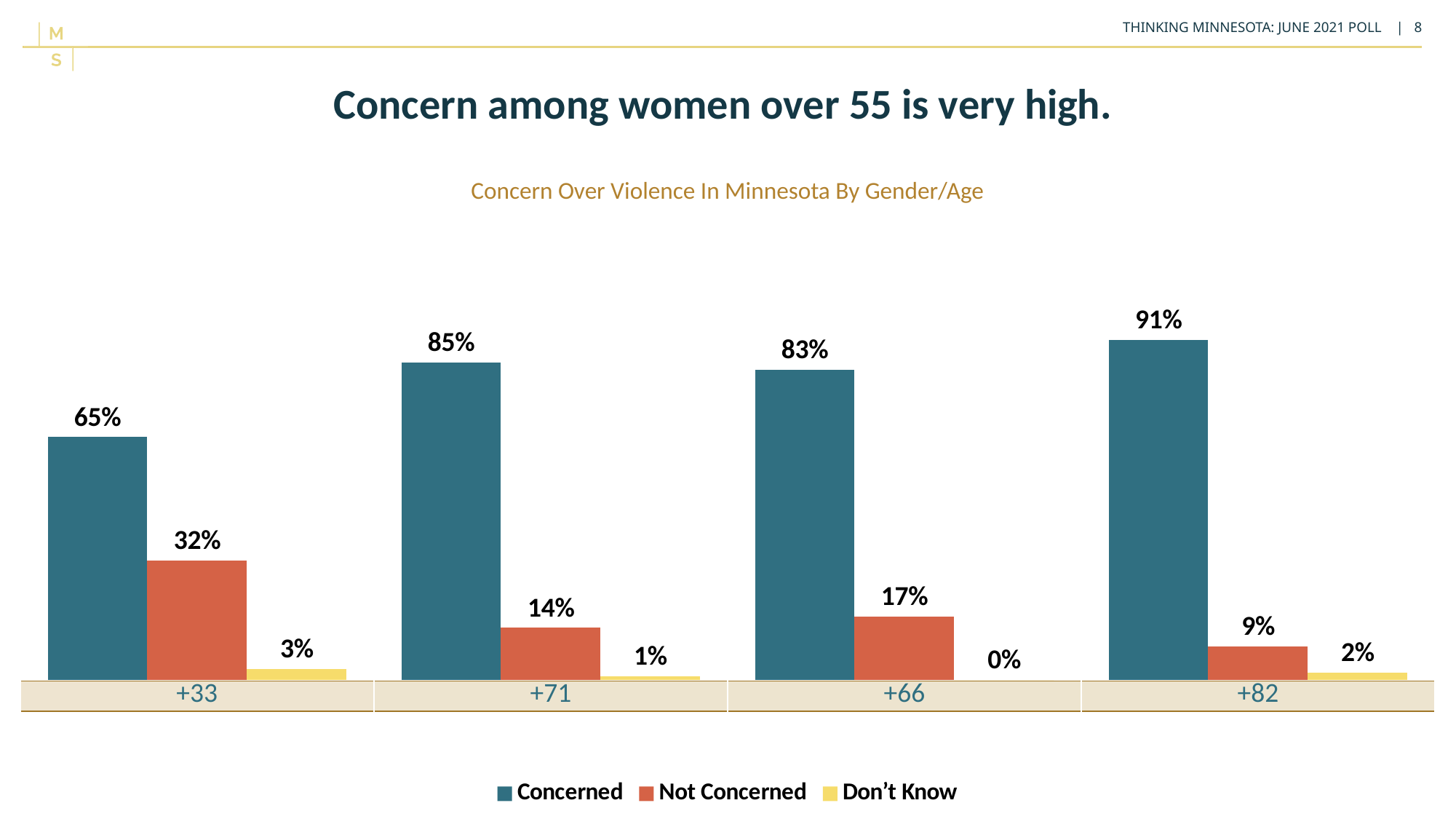
How much higher is the Concerned value in the rightmost group than in the leftmost group? 26 percentage points In the second group from the left, what is the difference between the Concerned and Not Concerned values? 71 percentage points What is the Don't Know value for the second group of bars from the left? 1% Which is larger: the Concerned value in the second group from the left or in the third group from the left? The second group (85%) What net figure is printed beneath the third group of bars from the left? +66 Which group of bars has the lowest Don't Know value? The third group from the left (0%) How many groups of bars are shown in the chart? 4 What is the Concerned value for the leftmost group of bars? 65% Which group of bars has the highest Concerned value? The rightmost group (91%) How many series does the legend list? 3 What type of chart is shown on the slide? Bar chart What is the Not Concerned value for the rightmost group of bars? 9%